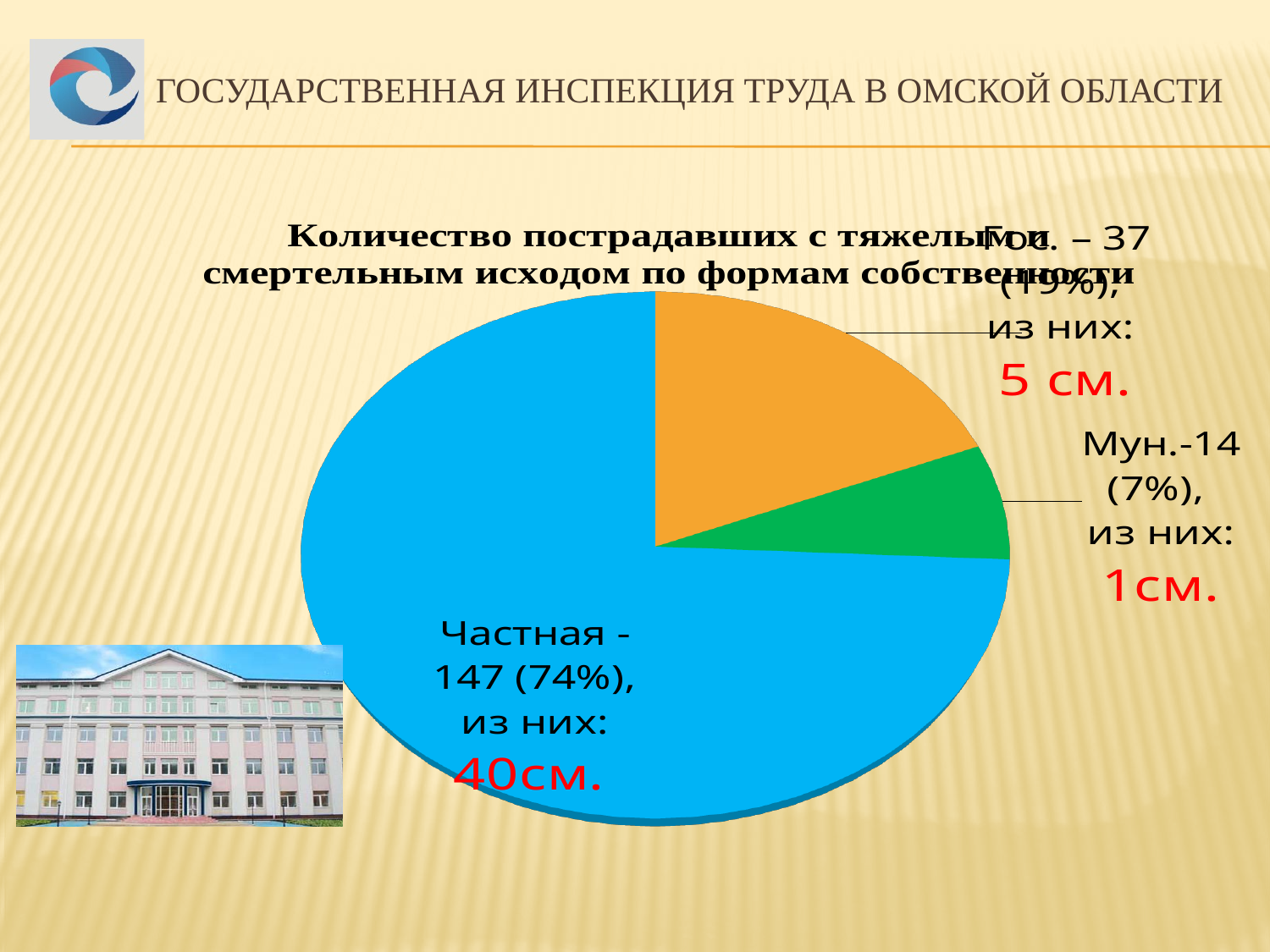
What is the number of victims for the Гос. (state) form of ownership? 37 How many fatal cases (см.) are indicated for the Частная slice? 40 Which form of ownership has the largest slice of the pie? Частная What is the number of victims for the Мун. (municipal) form of ownership? 14 Which has more victims, Гос. or Мун.? Гос. What share of the pie does the Частная slice represent? 74% What is the difference between the number of victims for Частная and for Гос.? 110 What kind of chart is shown on the slide? pie chart What is the number of victims for the Частная (private) form of ownership? 147 What share of the pie does the Мун. slice represent? 7% Which form of ownership has the smallest slice of the pie? Мун. How many slices does the pie chart have? 3